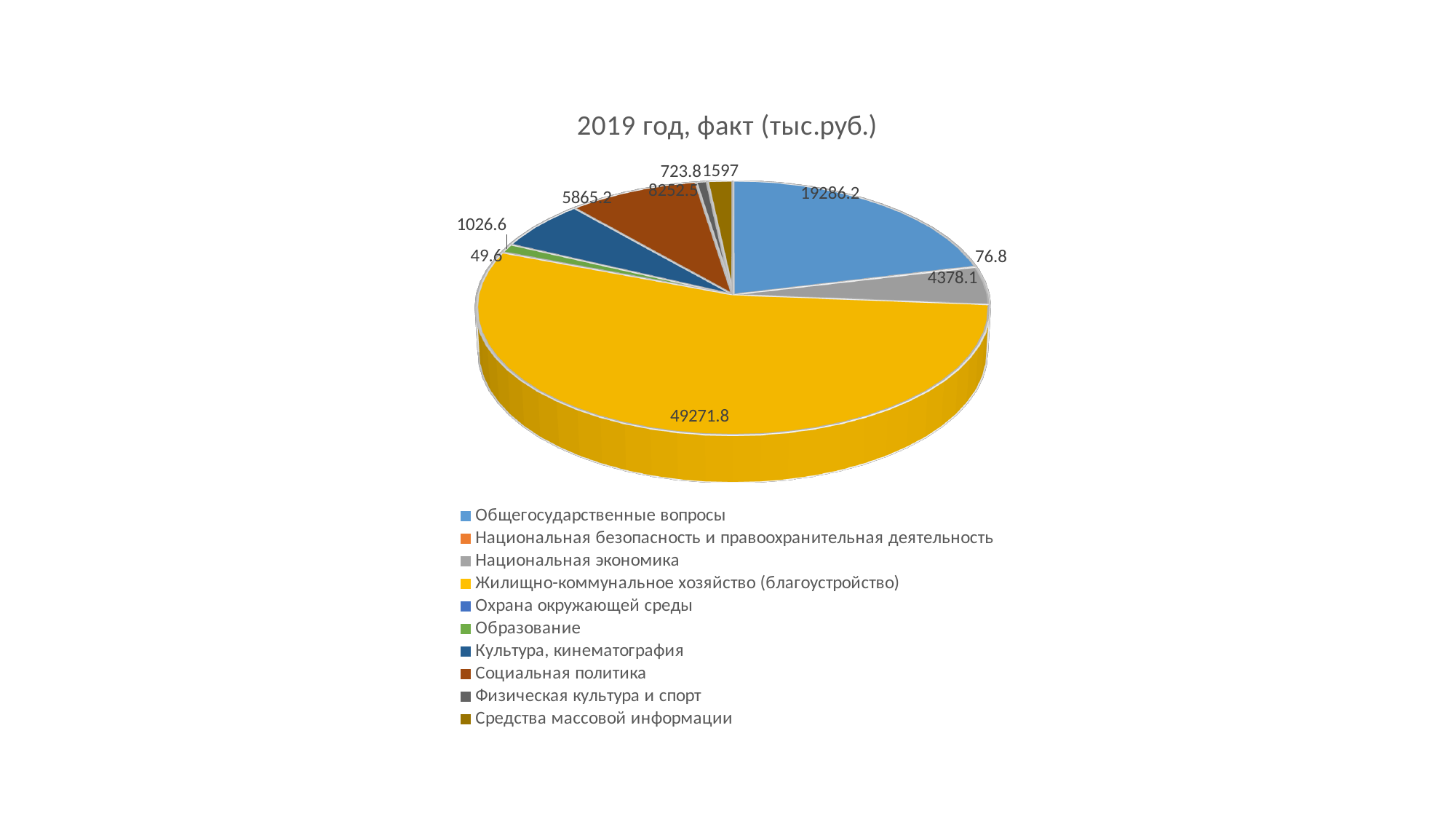
What is the difference between Общегосударственные вопросы and Национальная экономика? 14908.1 What type of chart is shown on the slide? Pie chart What is the difference between Средства массовой информации and Физическая культура и спорт? 873.2 What is the value for Средства массовой информации? 1597 What is the value for Жилищно-коммунальное хозяйство (благоустройство)? 49271.8 What is the value for Культура, кинематография? 5865.2 Which is larger, Социальная политика or Культура, кинематография? Социальная политика What is the value for Общегосударственные вопросы? 19286.2 Which category has the largest slice? Жилищно-коммунальное хозяйство (благоустройство) Which category has the smallest value? Охрана окружающей среды How many categories does the legend list? 10 What is the title of the chart? 2019 год, факт (тыс.руб.)